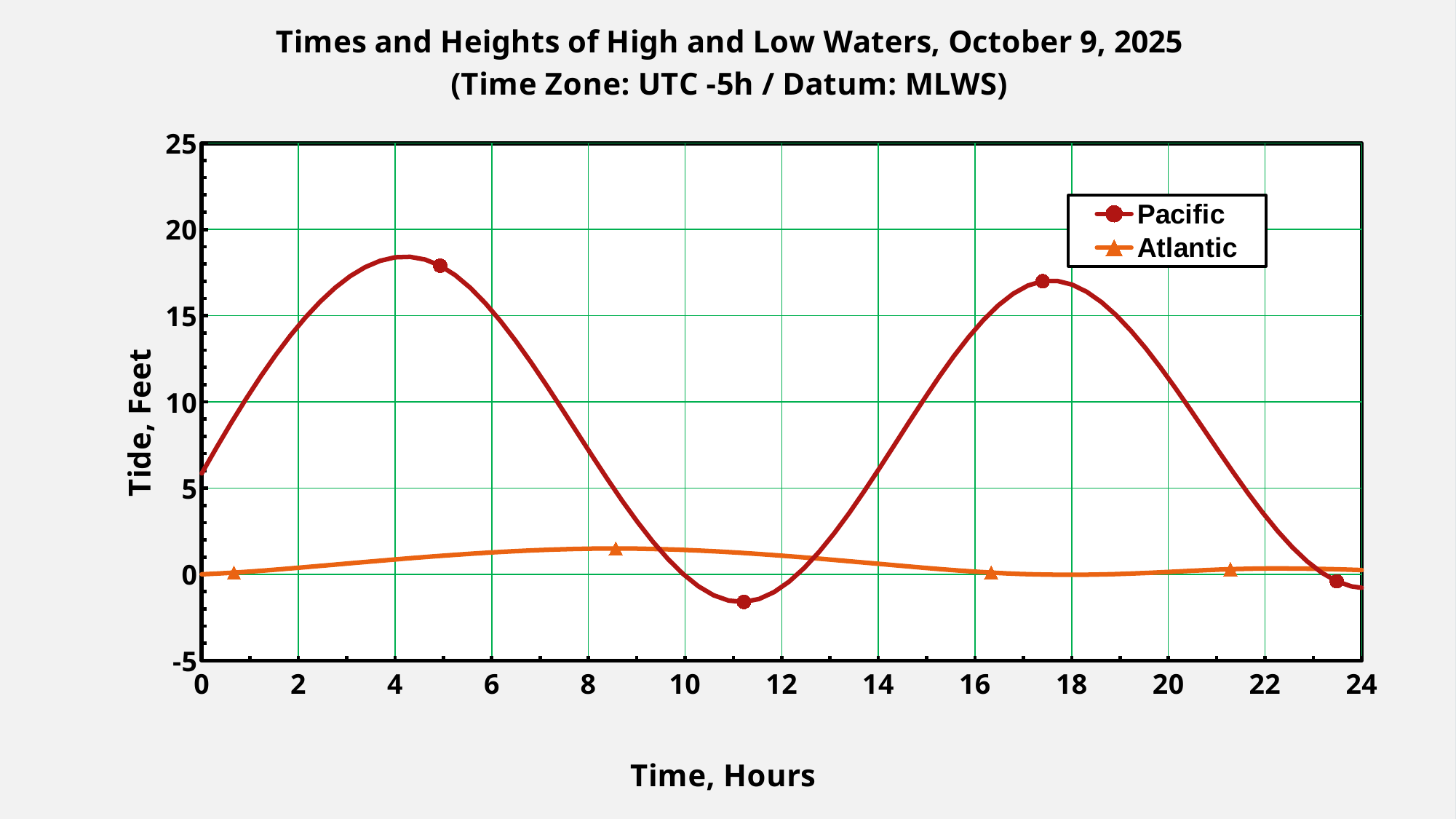
How many series does the legend list? 2 At around hour 5, which series has the larger value, Pacific or Atlantic? Pacific Is the value of the Pacific marker near hour 5 greater or less than 15? greater What are the two series named in the legend? Pacific and Atlantic What kind of chart is shown on the slide? line chart Does the Pacific line rise or fall between hour 5 and hour 11? fall Is the value of the Pacific marker near hour 17 greater or less than 15? greater Is the value of the Atlantic marker near hour 9 greater or less than 5? less How many marked data points does the Pacific series have? 4 Which series reaches the highest tide value on the chart? Pacific What is the label on the vertical axis? Tide, Feet